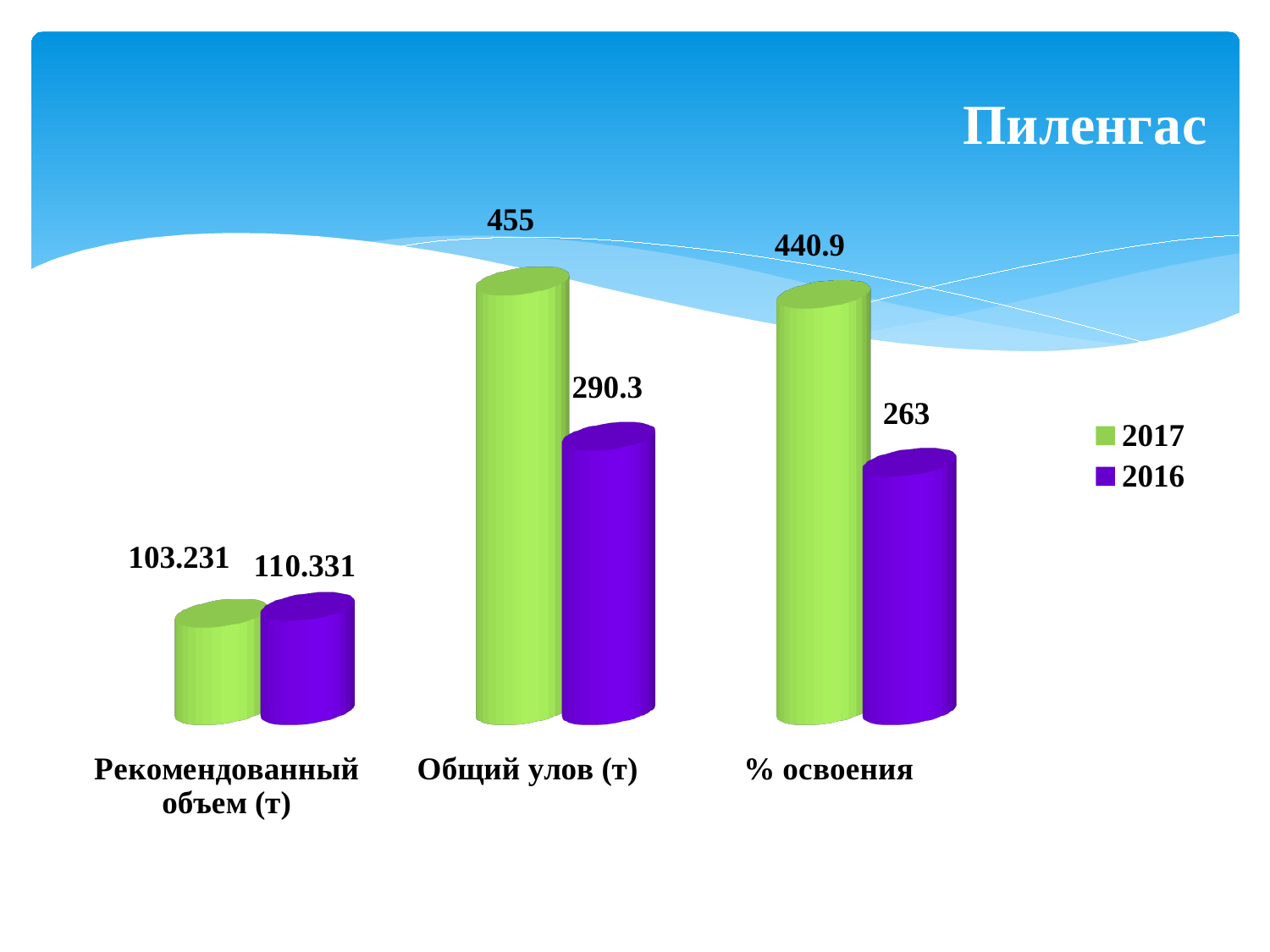
How many categories are shown on the x axis? 3 What is the 2016 value for Рекомендованный объем (т)? 110.331 Which is larger for Рекомендованный объем (т): the 2017 value or the 2016 value? 2016 What kind of chart is shown on the slide? Bar chart What is the difference between the 2017 and 2016 values for Общий улов (т)? 164.7 What is the 2016 value for % освоения? 263 Which category has the lowest 2016 value? Рекомендованный объем (т) What is the 2017 value for Рекомендованный объем (т)? 103.231 What is the difference between the 2017 and 2016 values for % освоения? 177.9 Which category has the highest 2017 value? Общий улов (т) What is the 2017 value for Общий улов (т)? 455 How many series does the legend list? 2